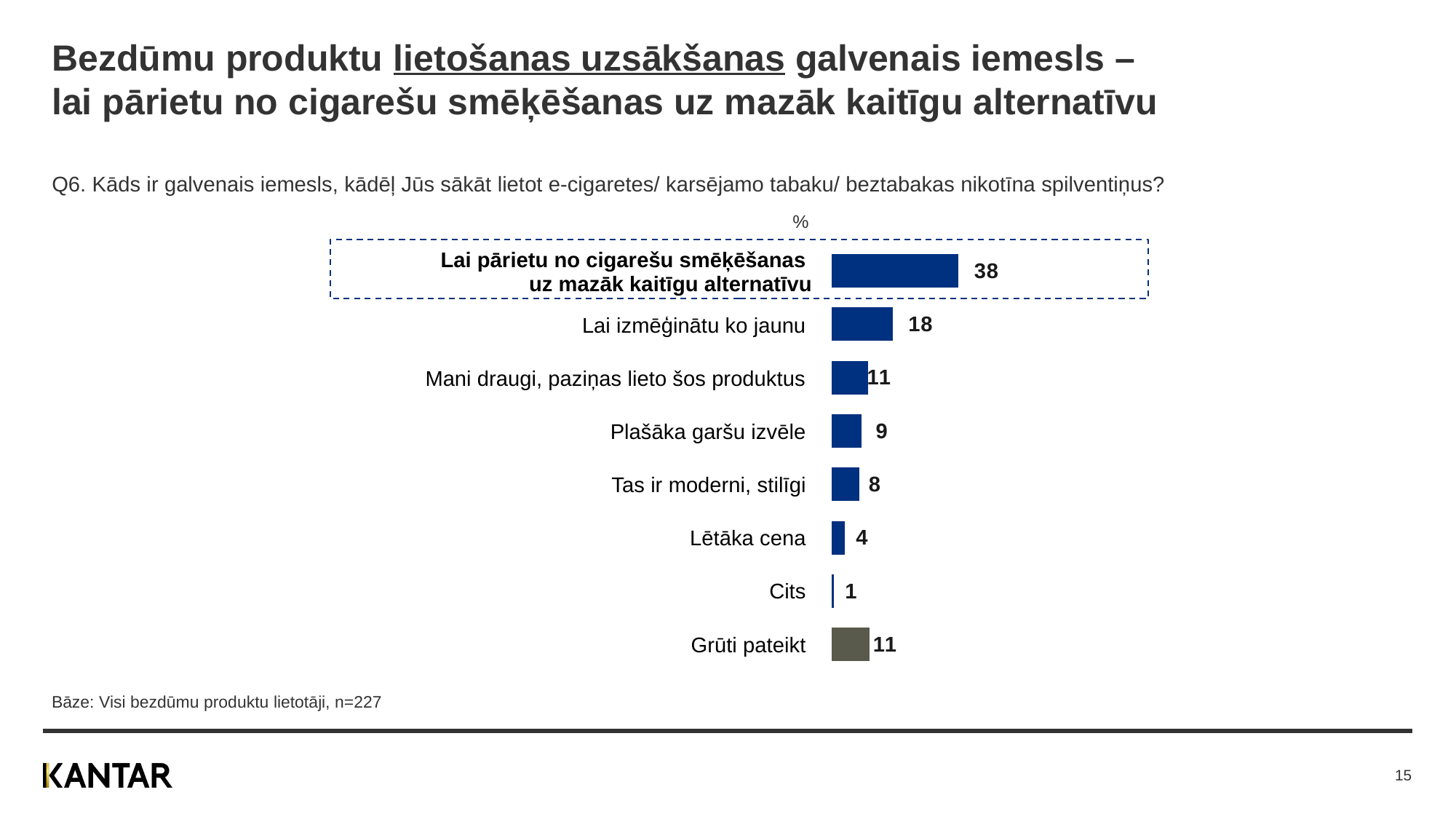
How many categories are shown in the chart? 8 Which category has the lowest value? Cits What is the value for "Lai izmēģinātu ko jaunu"? 18 What is the value for "Plašāka garšu izvēle"? 9 What is the difference between the values for "Mani draugi, paziņas lieto šos produktus" and "Cits"? 10 Which category's bar is drawn in a different (grey) colour from the others? Grūti pateikt What kind of chart is shown on the slide? Bar chart What is the value for "Lai pārietu no cigarešu smēķēšanas uz mazāk kaitīgu alternatīvu"? 38 Which category has the highest value? Lai pārietu no cigarešu smēķēšanas uz mazāk kaitīgu alternatīvu Which is larger: the value for "Tas ir moderni, stilīgi" or the value for "Lētāka cena"? Tas ir moderni, stilīgi What is the difference between the values for "Lai pārietu no cigarešu smēķēšanas uz mazāk kaitīgu alternatīvu" and "Lai izmēģinātu ko jaunu"? 20 What is the value for "Lētāka cena"? 4